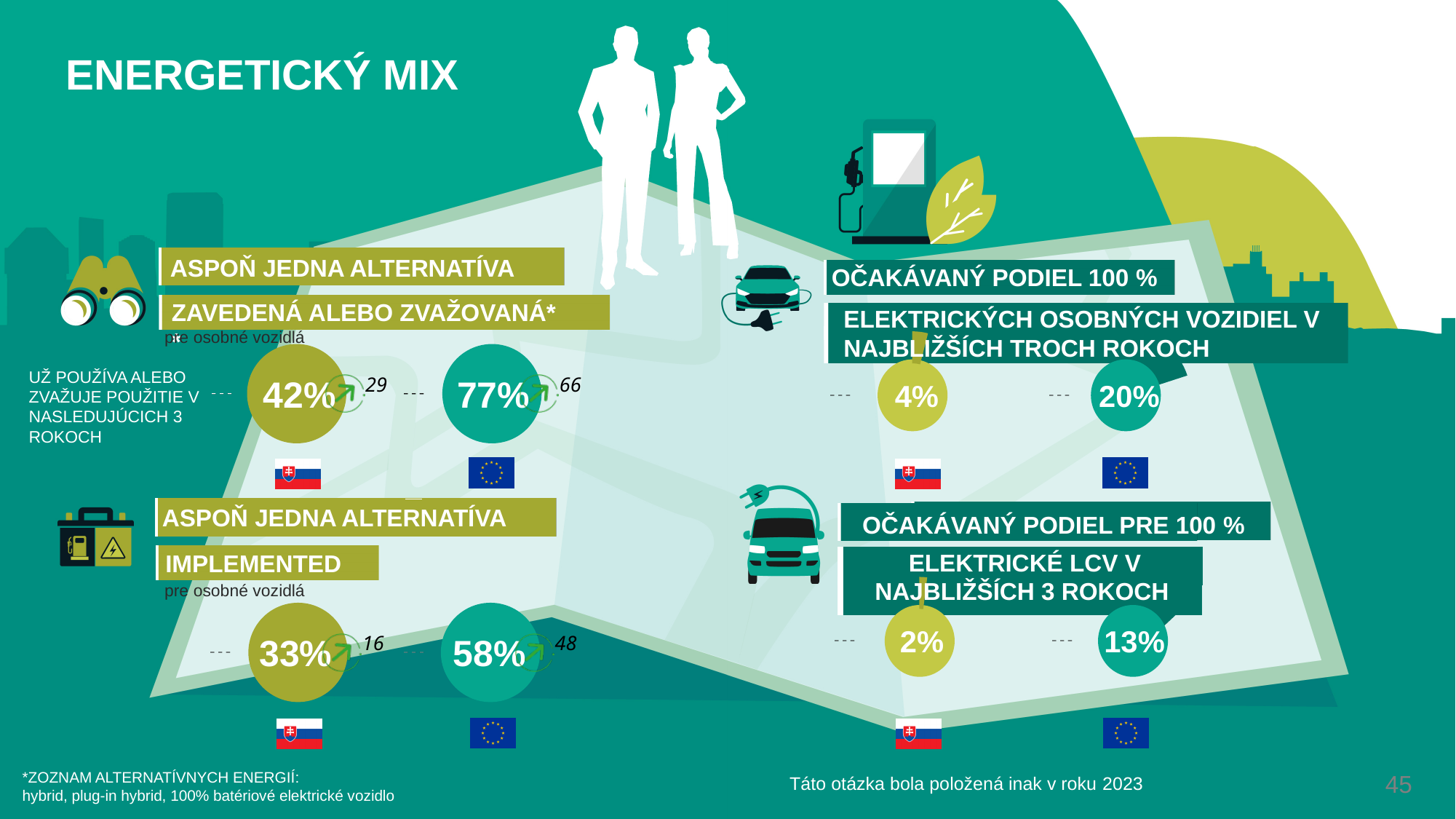
In the 'ASPOŇ JEDNA ALTERNATÍVA IMPLEMENTED' panel (bottom left), what is the value shown for Slovakia? 33% In the 'OČAKÁVANÝ PODIEL 100 % ELEKTRICKÝCH OSOBNÝCH VOZIDIEL V NAJBLIŽŠÍCH TROCH ROKOCH' panel (top right), what is the value for Slovakia? 4% In the 'ASPOŇ JEDNA ALTERNATÍVA IMPLEMENTED' panel (bottom left), what previous value (small italic number) is shown next to the Slovakia 33% circle? 16 What is the title of the slide? ENERGETICKÝ MIX In the 'OČAKÁVANÝ PODIEL 100 % ELEKTRICKÝCH OSOBNÝCH VOZIDIEL' panel (top right), which is larger, the Slovakia value or the EU value? EU In the 'ASPOŇ JEDNA ALTERNATÍVA ZAVEDENÁ ALEBO ZVAŽOVANÁ*' panel (top left), what is the difference between the EU value and the Slovakia value? 35 percentage points In the 'OČAKÁVANÝ PODIEL PRE 100 % ELEKTRICKÉ LCV' panel (bottom right), what is the difference between the EU value and the Slovakia value? 11 percentage points In the 'ASPOŇ JEDNA ALTERNATÍVA IMPLEMENTED' panel (bottom left), what is the value shown for the EU? 58% In the 'ASPOŇ JEDNA ALTERNATÍVA ZAVEDENÁ ALEBO ZVAŽOVANÁ*' panel (top left), what previous value (small italic number) is shown next to the EU 77% circle? 66 In the 'OČAKÁVANÝ PODIEL PRE 100 % ELEKTRICKÉ LCV V NAJBLIŽŠÍCH 3 ROKOCH' panel (bottom right), what is the value for the EU? 13% In the 'ASPOŇ JEDNA ALTERNATÍVA ZAVEDENÁ ALEBO ZVAŽOVANÁ*' panel (top left), what is the value shown for Slovakia (Slovak flag)? 42% In the 'ASPOŇ JEDNA ALTERNATÍVA ZAVEDENÁ ALEBO ZVAŽOVANÁ*' panel (top left), what is the value shown for the EU (EU flag)? 77%